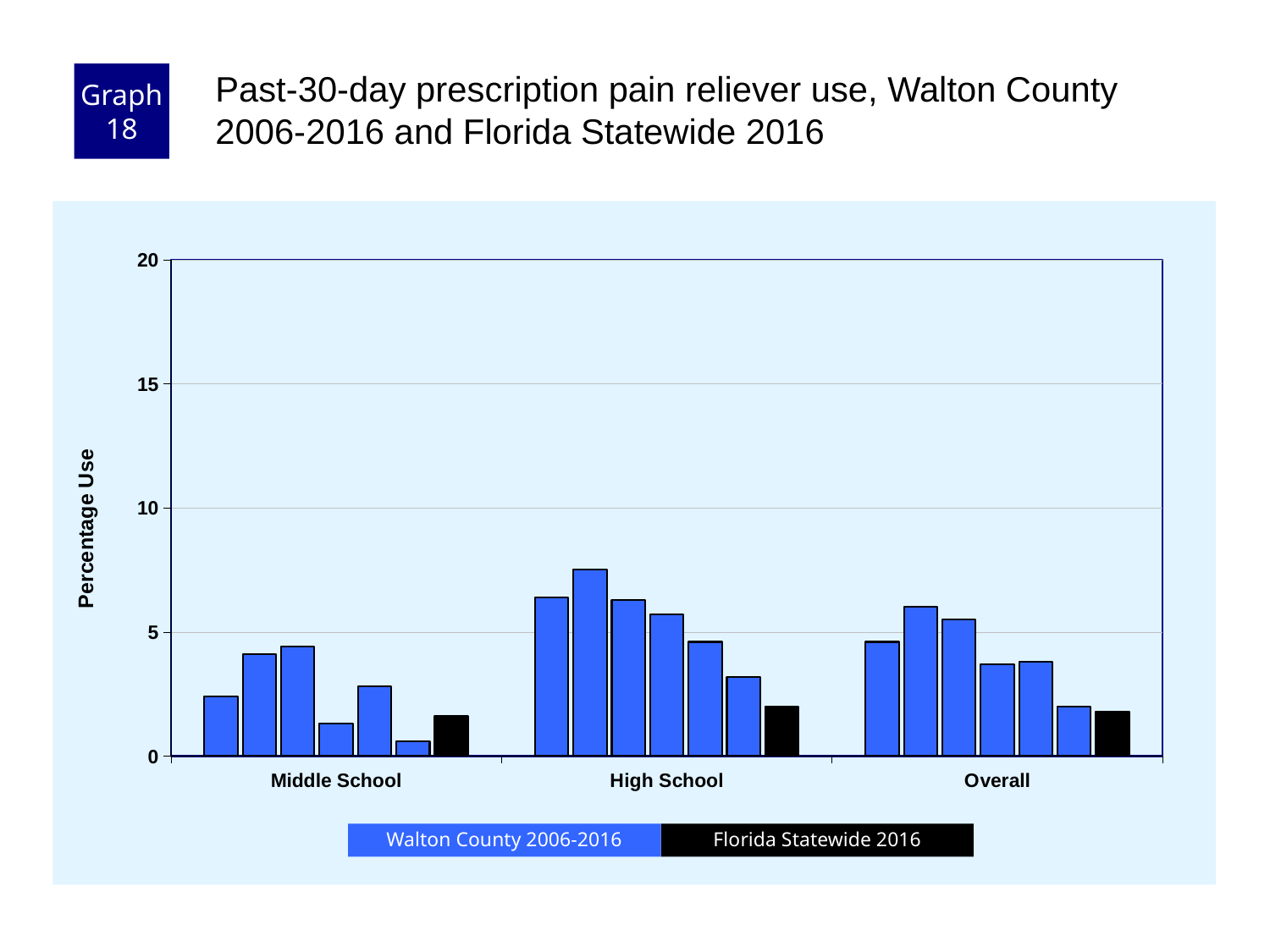
Which category contains the shortest bar on the chart? Middle School Which category contains the tallest bar on the chart? High School Which colour represents Florida Statewide 2016 in the legend? black Is the tallest Walton County 2006-2016 bar for High School greater or less than 5? greater Is the tallest Walton County 2006-2016 bar for Middle School greater or less than 5? less What kind of chart is shown on the slide? bar chart What is the label on the y axis? Percentage Use How many categories are shown on the x axis? 3 Is the Florida Statewide 2016 value for Overall greater or less than 5? less How many series does the legend list? 2 Which is larger: the tallest Walton County bar for High School or the tallest Walton County bar for Overall? High School